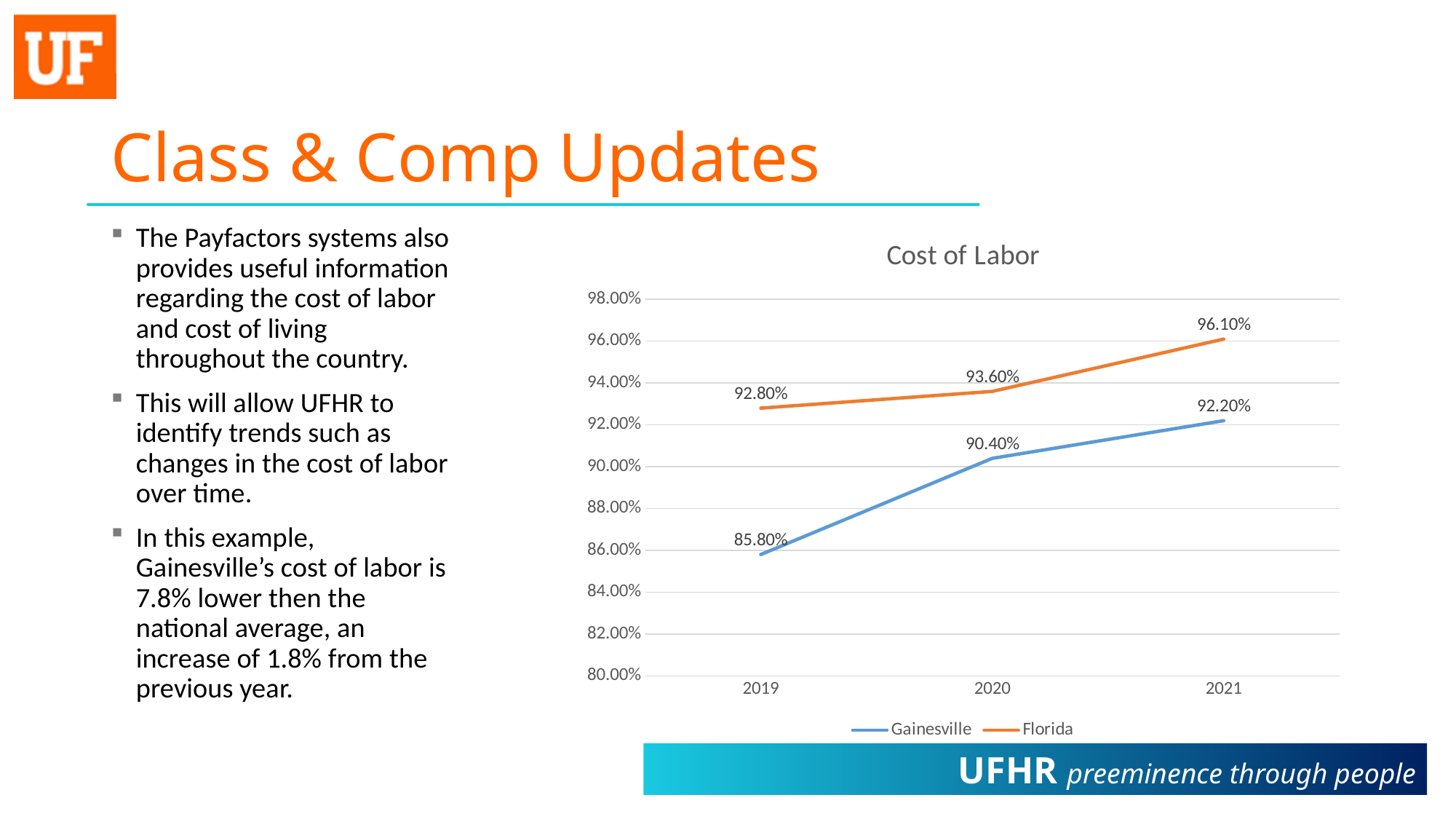
What is the Gainesville cost of labor value for 2019? 85.80% In which year is the Gainesville value highest? 2021 Does the Gainesville line rise or fall from 2019 to 2021? Rise What kind of chart is shown on the slide? Line chart In which year is the Florida value lowest? 2019 How many years are shown on the x axis? 3 How many series does the legend list? 2 What is the Gainesville value for 2020? 90.40% What is the Florida cost of labor value for 2021? 96.10% Which is larger in 2020, the Gainesville value or the Florida value? Florida What is the Florida value for 2019? 92.80% What is the difference between the Florida and Gainesville values in 2021? 3.90%